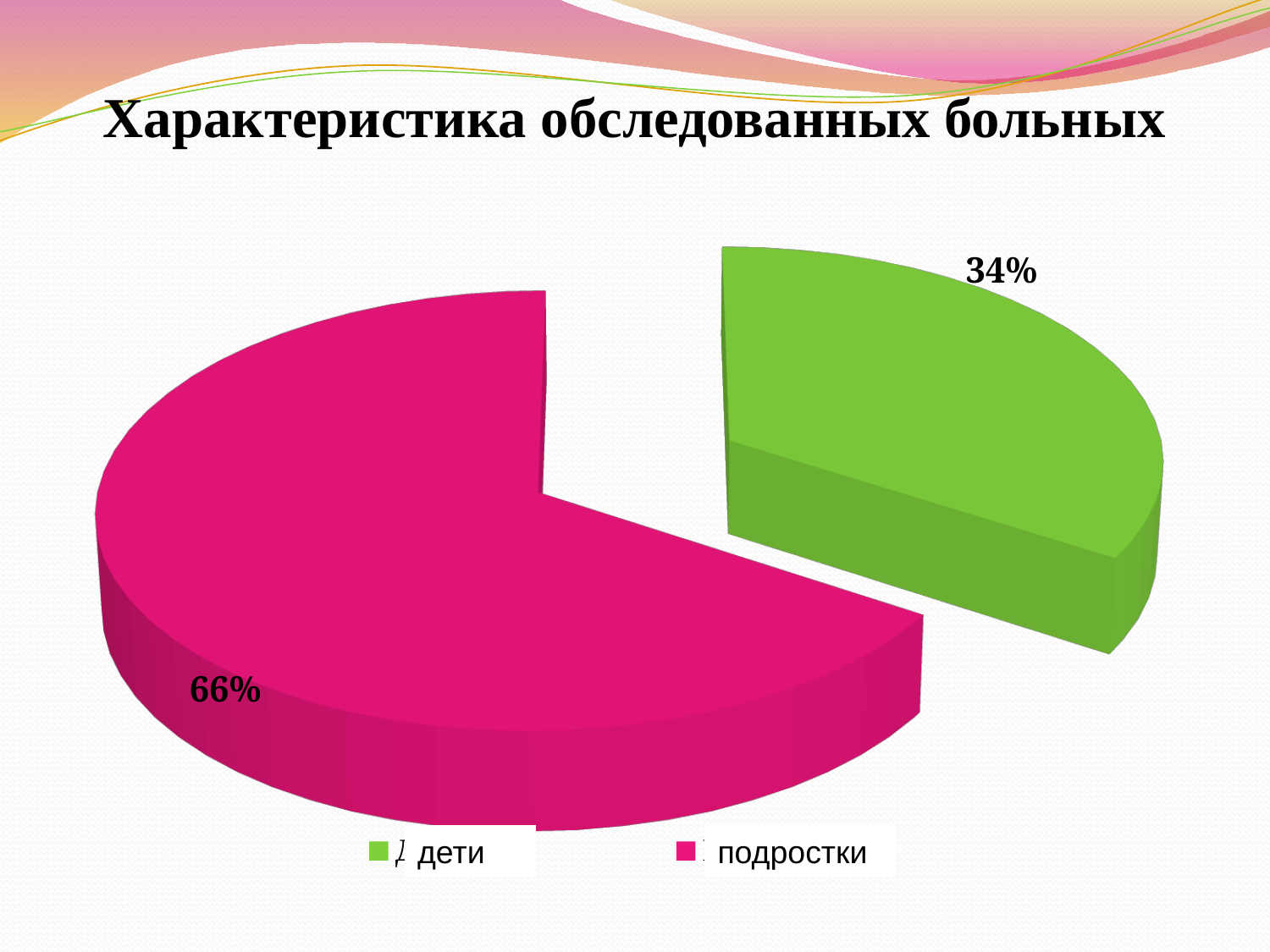
Which category has the smallest slice of the pie? дети What share of the pie does the 'подростки' slice represent? 66% What is the difference in percentage points between the 'подростки' and 'дети' slices? 32 How many slices does the pie chart have? 2 Which slice is larger, 'дети' or 'подростки'? подростки What is the title of the slide? Характеристика обследованных больных Which category has the largest slice of the pie? подростки What share of the pie does the 'дети' slice represent? 34% How many entries does the legend list? 2 What kind of chart is shown on the slide? pie chart What colour is the 'дети' slice? green Is the share for 'подростки' greater or less than 50%? greater